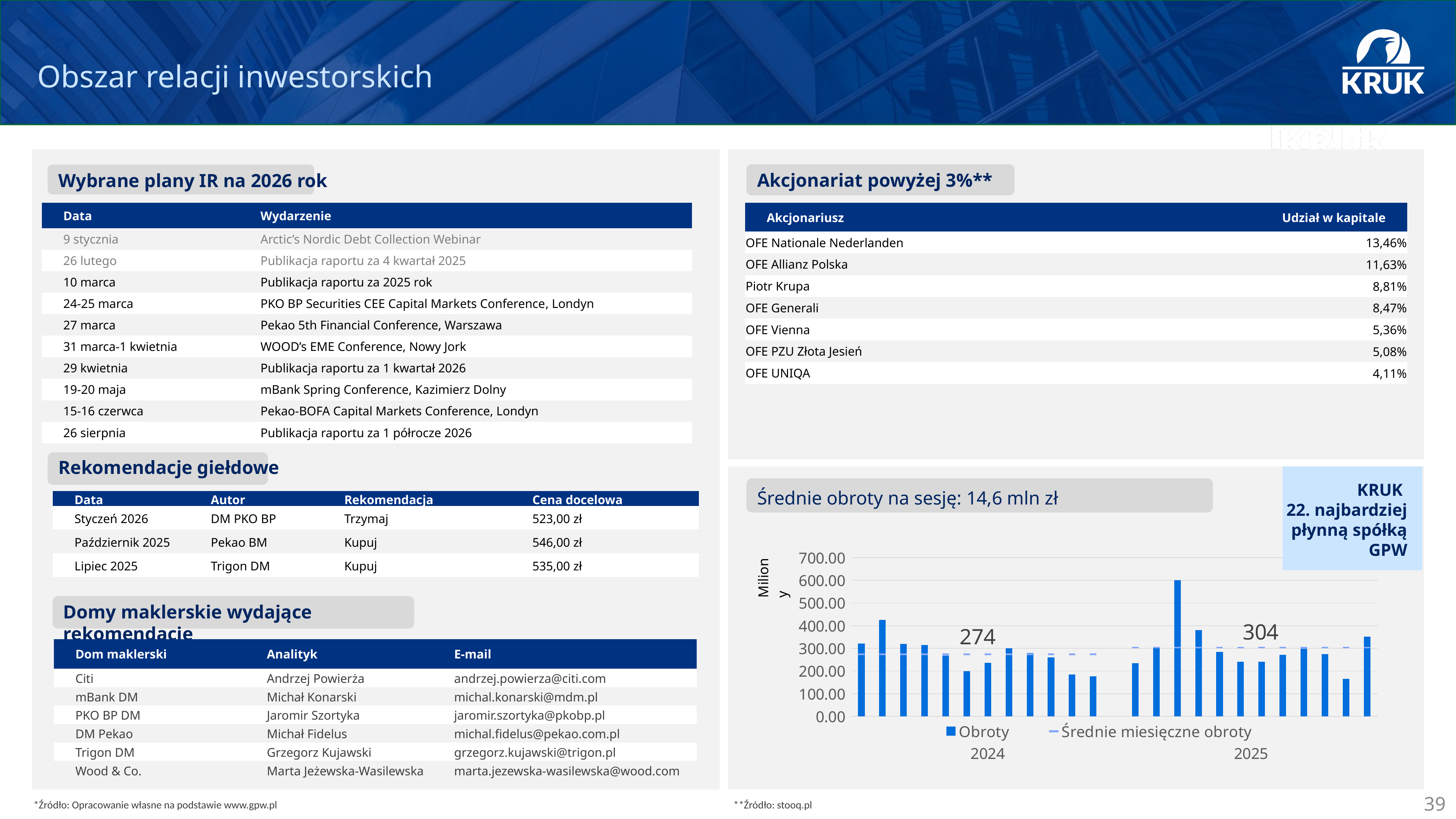
In the 'Średnie obroty na sesję' chart, is the 2024 average monthly turnover greater or less than 300? less In the 'Średnie obroty na sesję' chart, what is the difference between the 2025 average (304) and the 2024 average (274)? 30 In the 'Średnie obroty na sesję' chart, in which year does the tallest bar appear? 2025 What is the highest tick value shown on the y axis of the 'Średnie obroty na sesję' chart? 700.00 What are the two legend entries of the 'Średnie obroty na sesję' chart? Obroty; Średnie miesięczne obroty What kind of chart is shown under the heading 'Średnie obroty na sesję: 14,6 mln zł'? combination bar and line chart How many series does the legend of the 'Średnie obroty na sesję' chart list? 2 In the 'Średnie obroty na sesję' chart, is the value of the tallest bar greater or less than 500? greater How many monthly bars are plotted in total in the 'Średnie obroty na sesję' chart? 24 In the 'Średnie obroty na sesję' chart, which year has the higher labelled average monthly turnover, 2024 or 2025? 2025 In the 'Średnie obroty na sesję' chart, what is the labelled average monthly turnover for 2025? 304 In the 'Średnie obroty na sesję' chart, what is the labelled average monthly turnover for 2024? 274